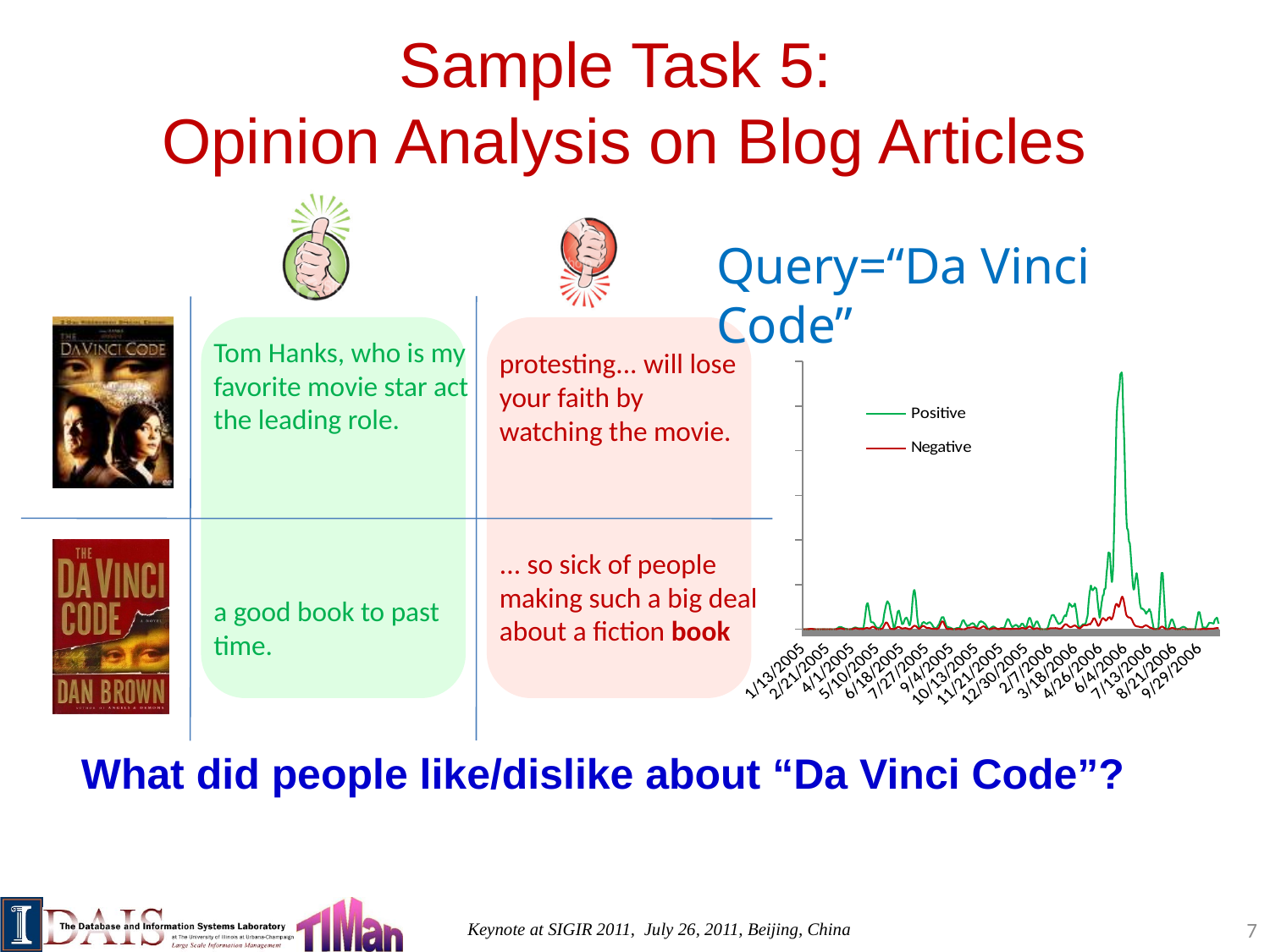
What is the last date label on the x axis of the line chart? 9/29/2006 How many date labels are shown along the x axis of the line chart? 17 Which series reaches the highest peak in the line chart, Positive or Negative? Positive What kind of chart is shown on the right side of the slide? line chart What colour is the Positive series line in the chart? green How many series does the legend of the line chart list? 2 What are the two series named in the legend of the line chart? Positive and Negative What query is the line chart about, according to the text above it? Da Vinci Code Near which x-axis date label does the Positive series reach its highest peak? 6/4/2006 Does the Positive series generally rise or fall from 4/26/2006 to 6/4/2006? rise Does the Positive series rise or fall from 6/4/2006 to 7/13/2006? fall What is the first date label on the x axis of the line chart? 1/13/2005